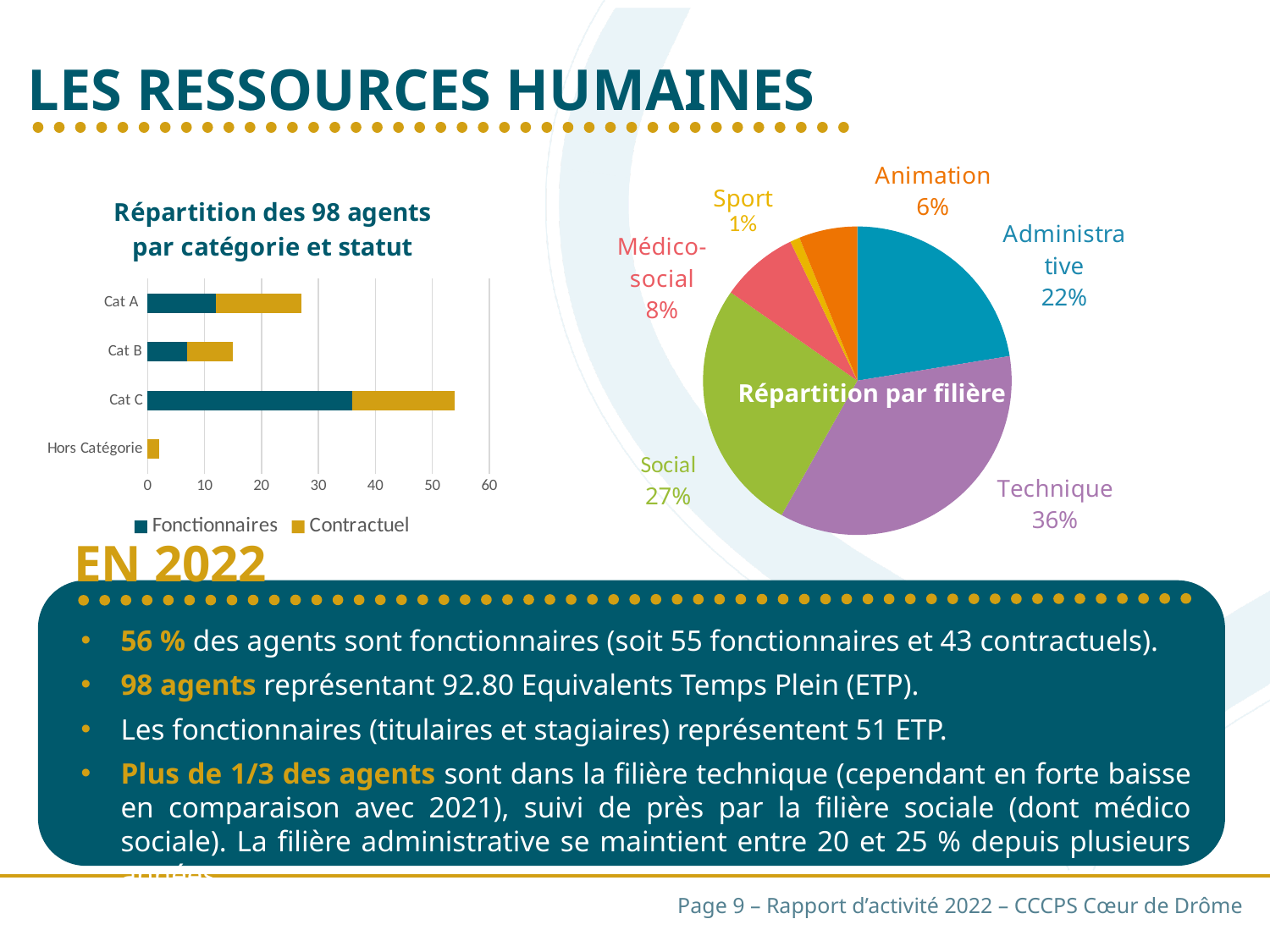
In the 'Répartition par filière' pie chart, what share does Technique have? 36% In the 'Répartition des 98 agents par catégorie et statut' chart, is the total value for Cat B greater or less than 20? less How many series does the legend of the 'Répartition des 98 agents par catégorie et statut' chart list? 2 How many slices does the 'Répartition par filière' pie chart have? 6 What kind of chart is the 'Répartition des 98 agents par catégorie et statut' chart? bar chart In the 'Répartition des 98 agents par catégorie et statut' chart, which category has the shortest total bar? Hors Catégorie In the 'Répartition des 98 agents par catégorie et statut' chart, which is larger: the total bar for Cat A or for Cat B? Cat A In the 'Répartition par filière' pie chart, which filière has the smallest share? Sport In the 'Répartition des 98 agents par catégorie et statut' chart, which category has the longest total bar? Cat C How many categories are shown on the 'Répartition des 98 agents par catégorie et statut' chart? 4 In the 'Répartition par filière' pie chart, what is the difference between the Technique share and the Social share? 9% In the 'Répartition des 98 agents par catégorie et statut' chart, is the total value for Cat C greater or less than 50? greater